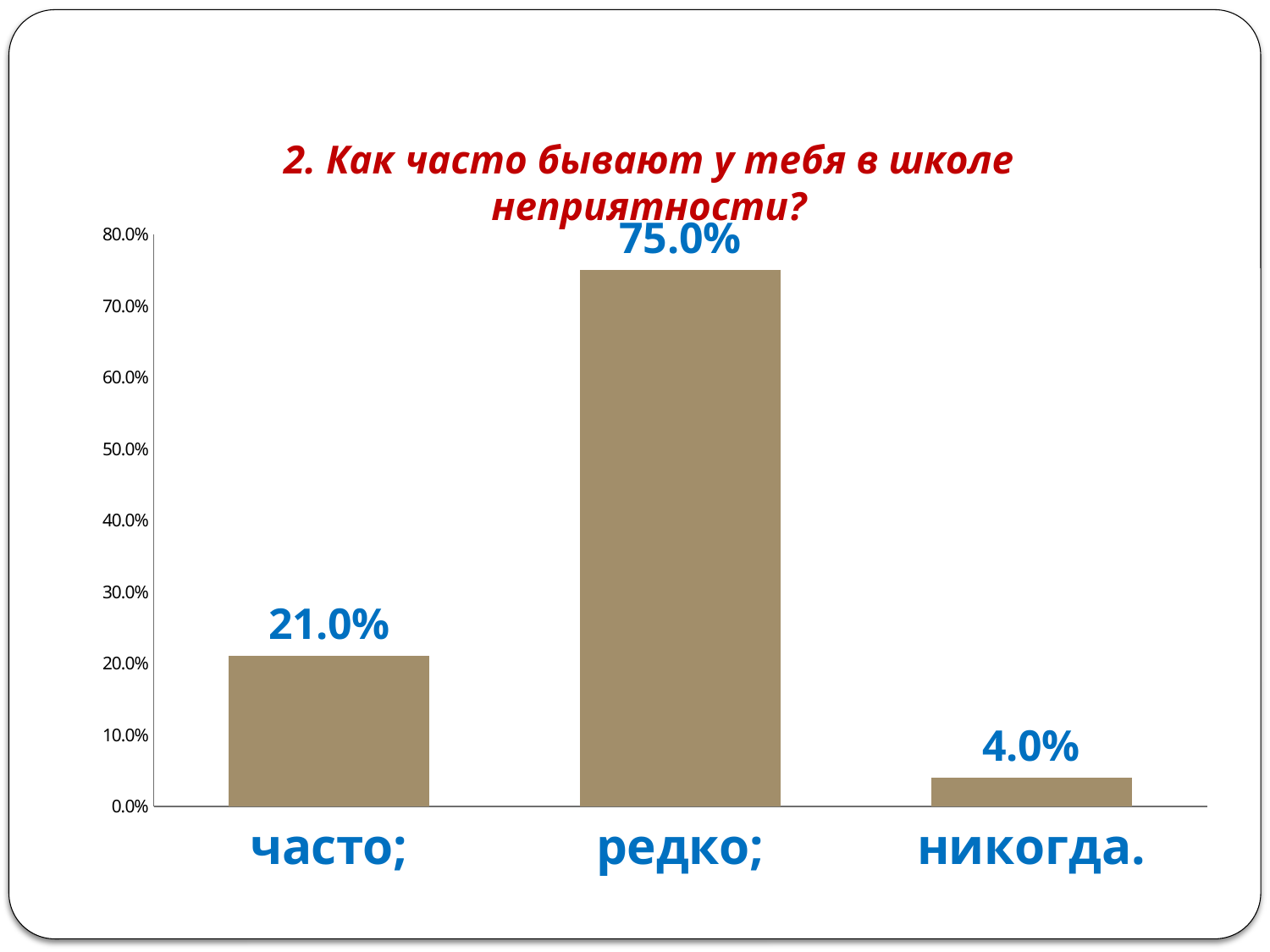
What is the value for "никогда"? 4.0% How many categories are shown on the x axis? 3 What is the value for "часто"? 21.0% Is the value for "редко" greater or less than 70.0%? greater What is the difference between the values for "редко" and "часто"? 54.0% Which is larger, the value for "часто" or the value for "никогда"? часто What is the title of the chart? 2. Как часто бывают у тебя в школе неприятности? Which category has the lowest value? никогда What is the difference between the values for "часто" and "никогда"? 17.0% What kind of chart is shown on the slide? bar chart Which category has the highest value? редко What is the value for "редко"? 75.0%